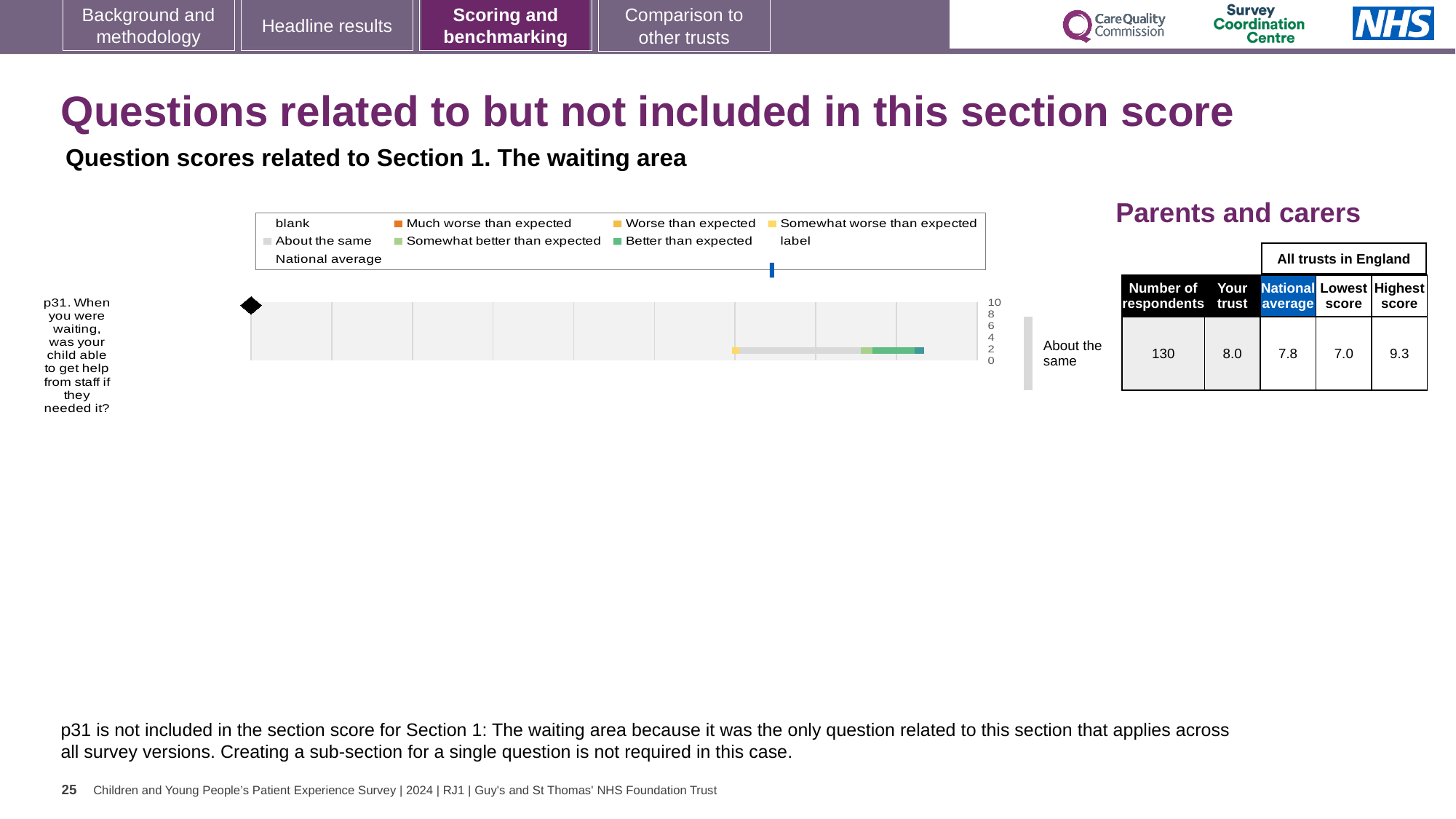
What is the national average score for question p31? 7.8 What is the 'Your trust' score for question p31? 8.0 What benchmark category is shown for question p31? About the same What kind of chart is used to show the score for question p31? bar chart What is the difference between the 'Your trust' score and the national average for question p31? 0.2 What is the highest score among all trusts in England for question p31? 9.3 Which question is plotted in the chart? p31. When you were waiting, was your child able to get help from staff if they needed it? How many respondents answered question p31? 130 How many questions are plotted in the chart? 1 What is the lowest score among all trusts in England for question p31? 7.0 What is the difference between the highest and lowest scores among all trusts in England for question p31? 2.3 Which is larger for question p31, the 'Your trust' score or the national average? Your trust